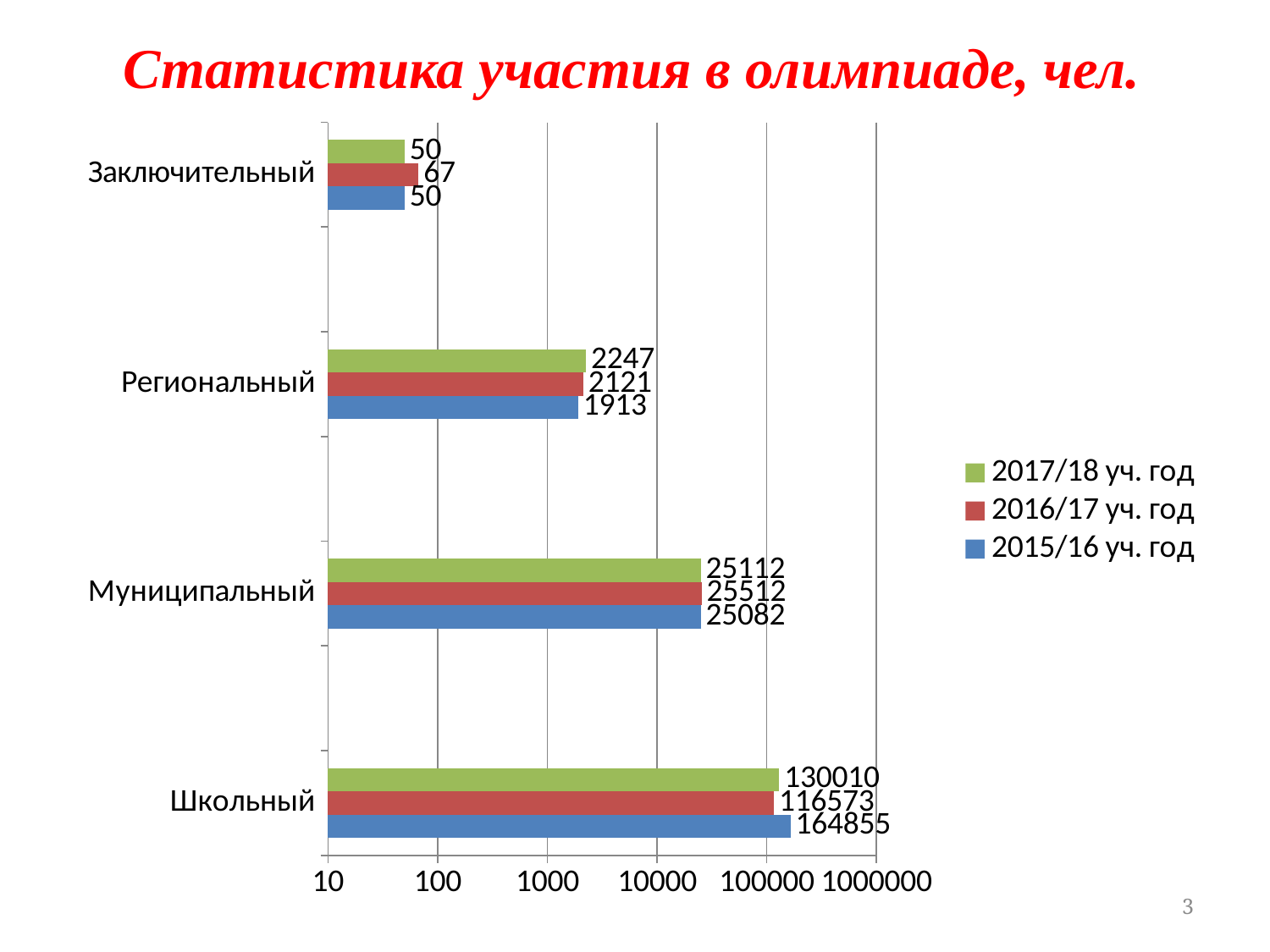
What is the difference between the 2017/18 уч. год and 2015/16 уч. год values for Региональный? 334 For Школьный, which is larger: the 2017/18 уч. год value or the 2016/17 уч. год value? 2017/18 уч. год What is the value for Муниципальный in the 2016/17 уч. год series? 25512 What type of chart is shown on the slide? Bar chart How many series does the legend list? 3 What is the value for Региональный in the 2017/18 уч. год series? 2247 What is the value for Заключительный in the 2016/17 уч. год series? 67 What is the value for Школьный in the 2015/16 уч. год series? 164855 What is the difference between the 2015/16 уч. год and 2016/17 уч. год values for Школьный? 48282 Which category has the lowest value in the 2015/16 уч. год series? Заключительный How many categories are shown on the chart? 4 Which category has the highest value in the 2017/18 уч. год series? Школьный